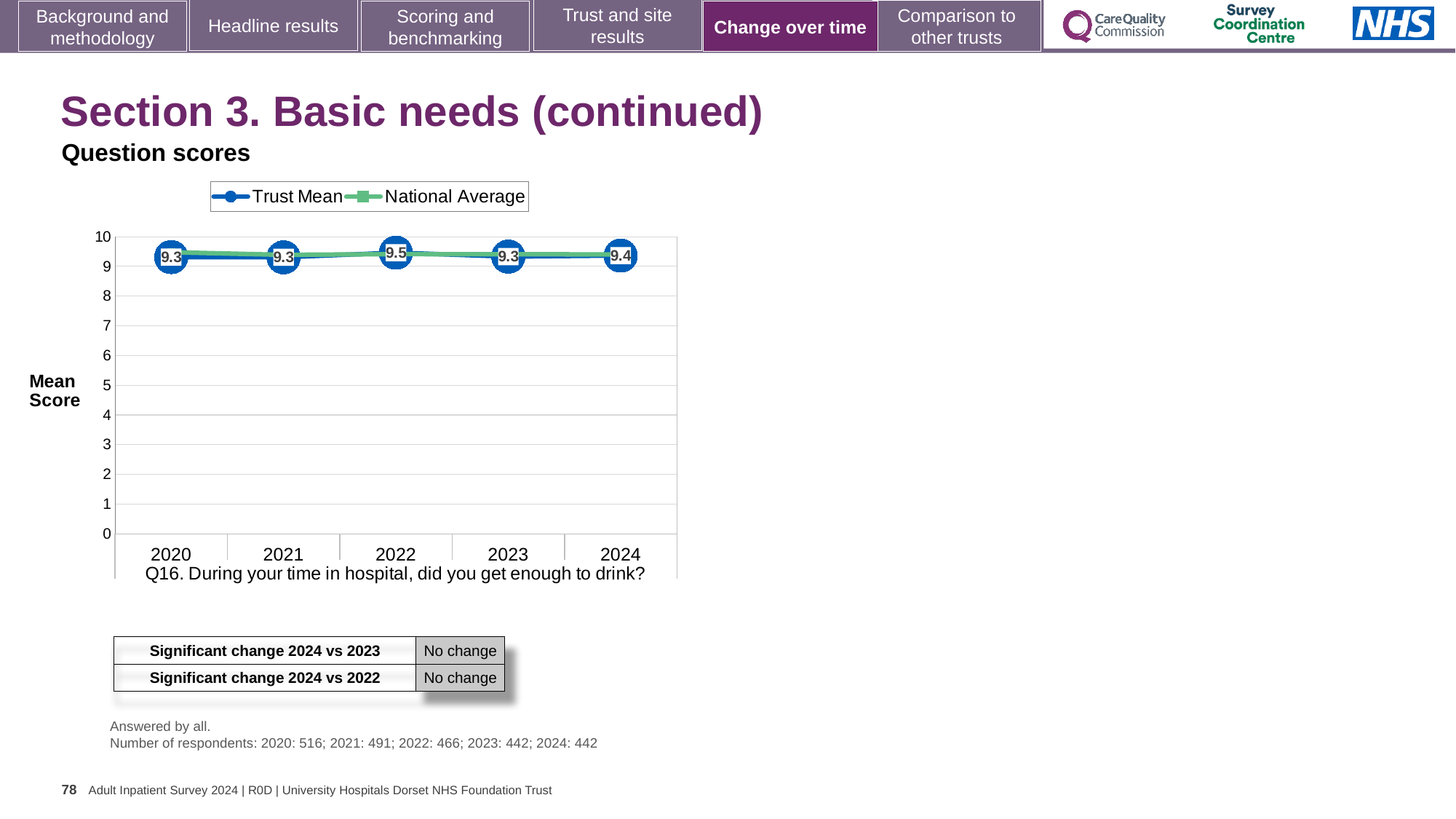
How many years are plotted on the x axis? 5 Which survey question does the chart relate to? Q16. During your time in hospital, did you get enough to drink? Does the Trust Mean score rise or fall from 2021 to 2022? rise Is the Trust Mean score for 2021 greater or less than 5? greater Which year has the larger Trust Mean score, 2022 or 2023? 2022 What is the Trust Mean score for 2020? 9.3 What is the Trust Mean score for 2024? 9.4 How many series does the legend list? 2 In which year is the Trust Mean score highest? 2022 What kind of chart is shown on the slide? line chart What is the difference between the Trust Mean scores for 2022 and 2024? 0.1 What is the Trust Mean score for 2022? 9.5